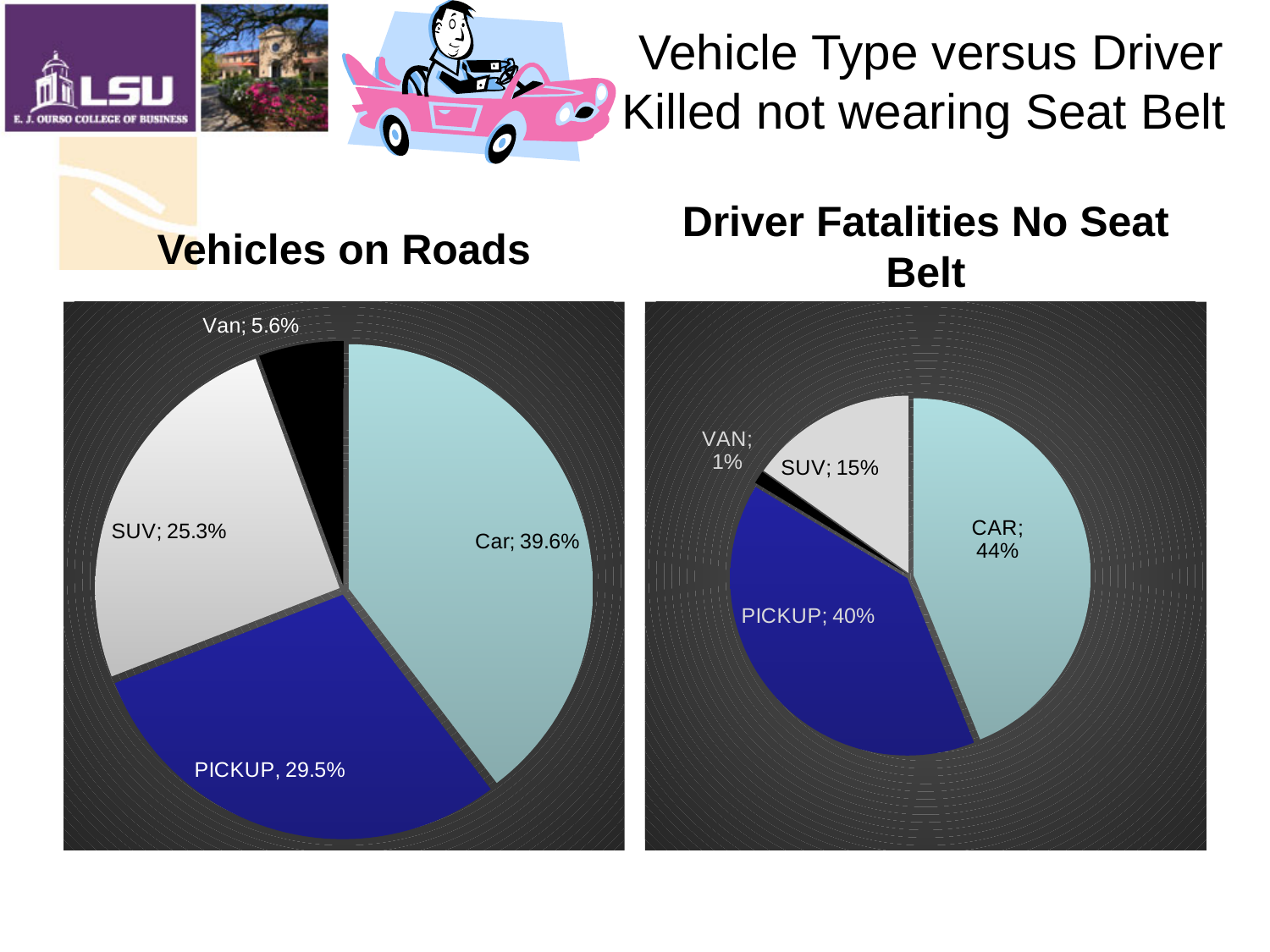
In the 'Driver Fatalities No Seat Belt' chart, which category has the smallest slice? VAN In the 'Vehicles on Roads' chart, which is larger, the SUV share or the Van share? SUV In the 'Vehicles on Roads' chart, which category has the largest slice? Car In the 'Driver Fatalities No Seat Belt' chart, what share is labelled for VAN? 1% What kind of chart is the 'Vehicles on Roads' chart? Pie chart In the 'Vehicles on Roads' chart, what is the difference between the Car and PICKUP shares? 10.1% In the 'Driver Fatalities No Seat Belt' chart, what is the difference between the CAR and SUV shares? 29% In the 'Vehicles on Roads' chart, what share is labelled for SUV? 25.3% What is the title of the chart on the right side of the slide? Driver Fatalities No Seat Belt How many slices does the 'Driver Fatalities No Seat Belt' chart have? 4 In the 'Vehicles on Roads' chart, what share is labelled for Car? 39.6% In the 'Driver Fatalities No Seat Belt' chart, what share is labelled for PICKUP? 40%